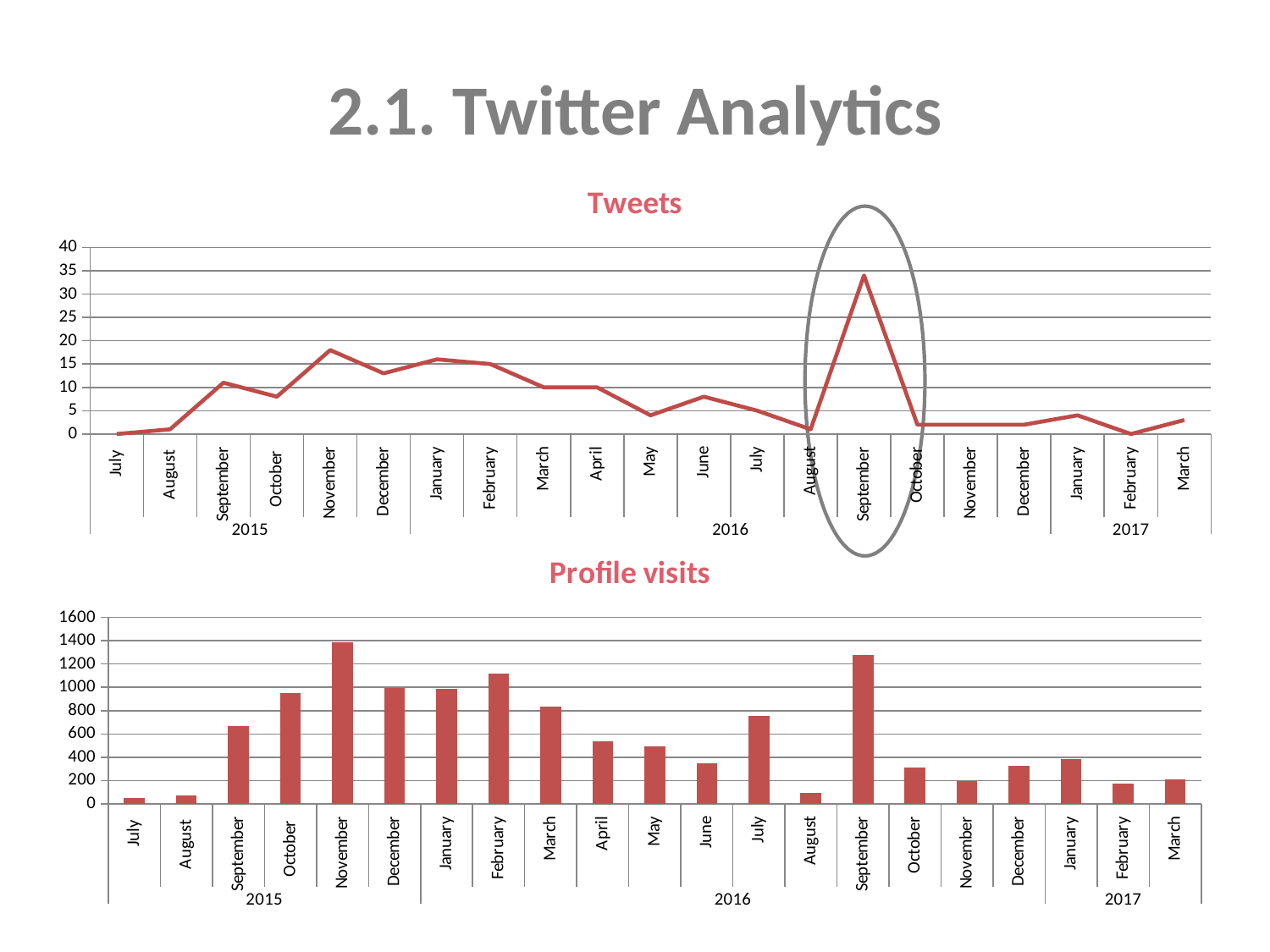
In the "Tweets" chart, which is larger, the value for November 2015 or the value for December 2015? November 2015 In the "Tweets" chart, is the value for September 2016 greater or less than 30? greater In the "Tweets" chart, which month has the highest number of tweets? September 2016 How many months are plotted in the "Profile visits" chart? 21 In the "Profile visits" chart, which is larger, the value for February 2016 or the value for March 2016? February 2016 In the "Tweets" chart, is the value for November 2015 greater or less than 15? greater In the "Profile visits" chart, which month has the lowest number of profile visits? July 2015 In the "Profile visits" chart, which month has the highest number of profile visits? November 2015 In the "Profile visits" chart, is the value for September 2016 greater or less than 1200? greater What kind of chart is the "Profile visits" chart? bar chart What kind of chart is the "Tweets" chart? line chart